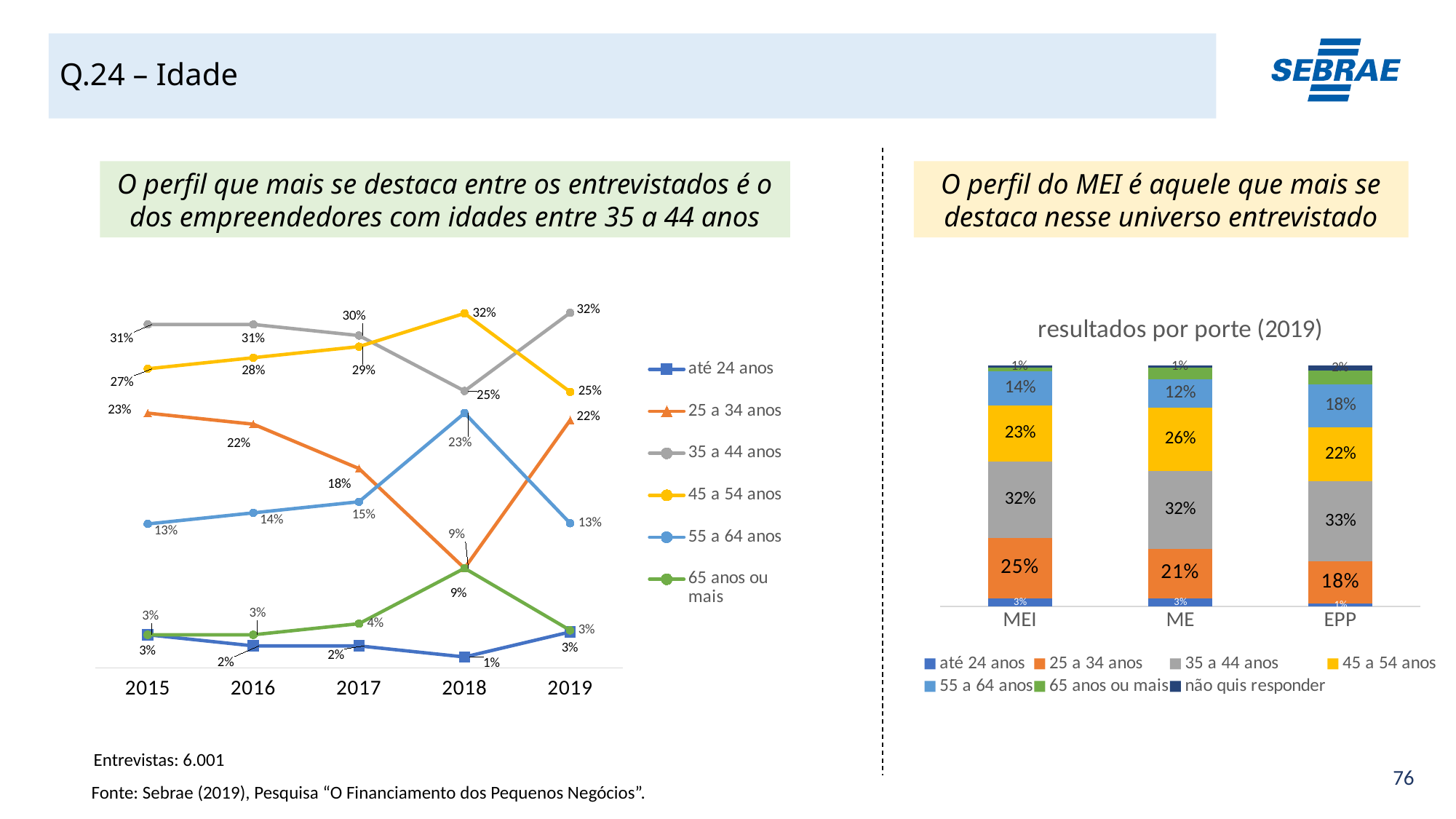
In the left line chart, what is the value for 25 a 34 anos in 2018? 9% In the chart titled 'resultados por porte (2019)', what is the value for 35 a 44 anos in the EPP bar? 33% In the left line chart, which is larger in 2018: 35 a 44 anos or 45 a 54 anos? 45 a 54 anos In the left line chart, which year has the lowest value for até 24 anos? 2018 In the chart titled 'resultados por porte (2019)', which bar has the highest value for 45 a 54 anos? ME How many series does the legend of the left line chart list? 6 In the chart titled 'resultados por porte (2019)', what is the value for 25 a 34 anos in the MEI bar? 25% What kind of chart is the chart titled 'resultados por porte (2019)'? Stacked bar chart In the left line chart, what is the value for 55 a 64 anos in 2017? 15% In the left line chart, which year has the highest value for 45 a 54 anos? 2018 In the left line chart, what is the difference between the 2015 and 2018 values for 25 a 34 anos? 14% In the left line chart, what is the value for 35 a 44 anos in 2019? 32%